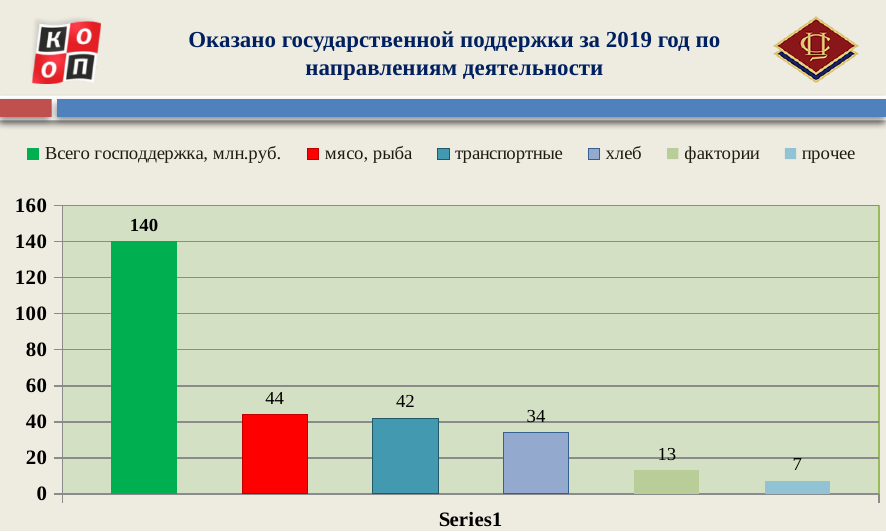
What is the value for "транспортные"? 42 Which is larger, the value for "фактории" or the value for "прочее"? фактории How many bars are plotted in the chart? 6 Which legend entry has the lowest value? прочее What kind of chart is shown on the slide? bar chart What is the value for "мясо, рыба"? 44 Which legend entry has the highest value? Всего господдержка, млн.руб. What is the value for "прочее"? 7 What is the title of the chart on the slide? Оказано государственной поддержки за 2019 год по направлениям деятельности What is the difference between the values for "мясо, рыба" and "хлеб"? 10 How many series does the legend list? 6 What is the value for "хлеб"? 34